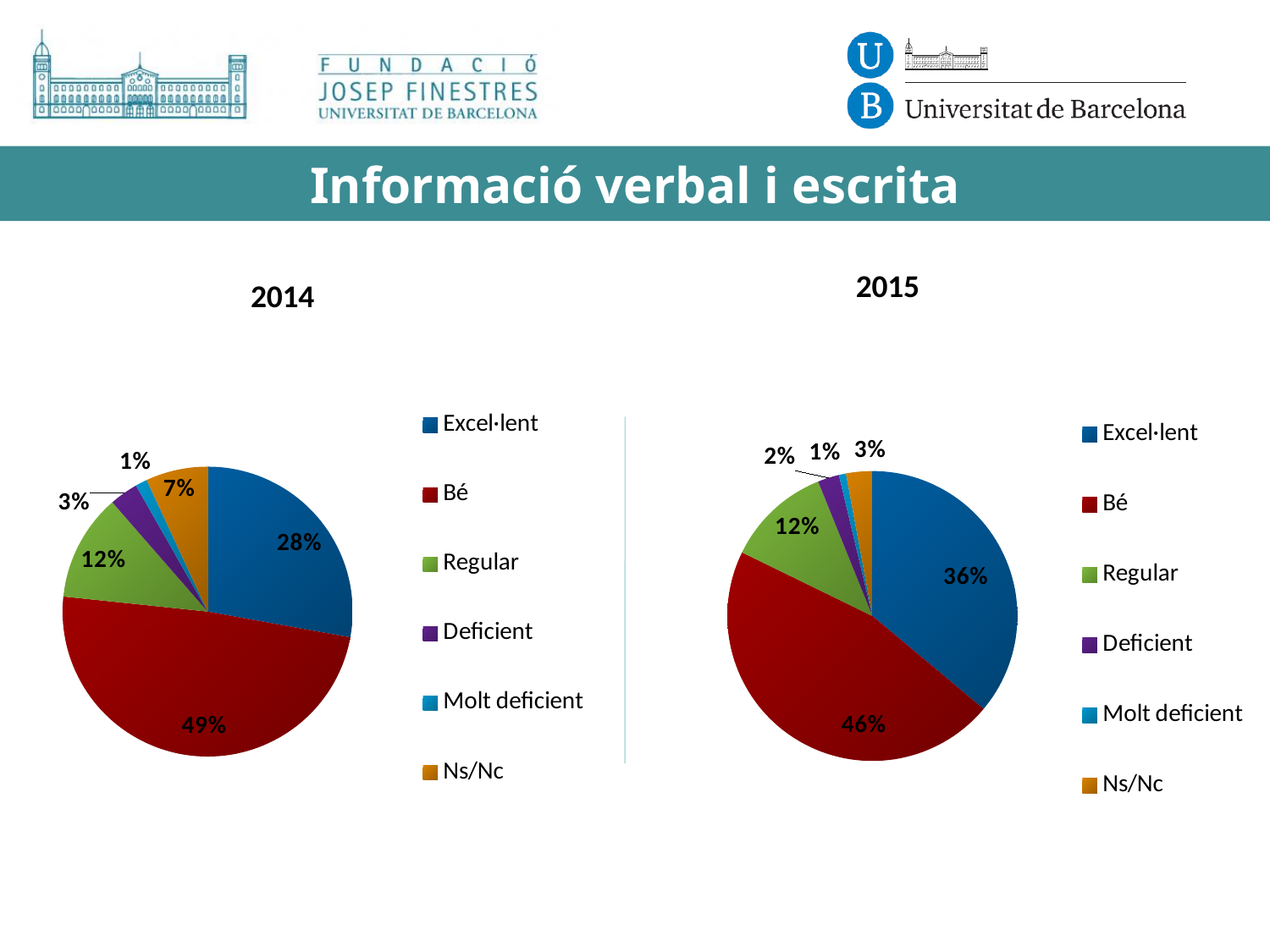
In the 2014 chart, what is the value for Ns/Nc? 7% What kind of chart is the 2014 chart? Pie chart In the 2015 chart, what is the difference between Bé and Excel·lent? 10% Which is larger in the 2014 chart: Regular or Ns/Nc? Regular In the 2015 chart, what is the value for Deficient? 2% In the 2014 chart, which category has the largest slice? Bé How many categories does the 2015 chart's legend list? 6 In the 2014 chart, what is the difference between Bé and Excel·lent? 21% In the 2015 chart, what share of the pie is Excel·lent? 36% In the 2015 chart, what colour is the Regular slice? Green In the 2015 chart, which category has the smallest slice? Molt deficient In the 2014 chart, what share of the pie is Bé? 49%